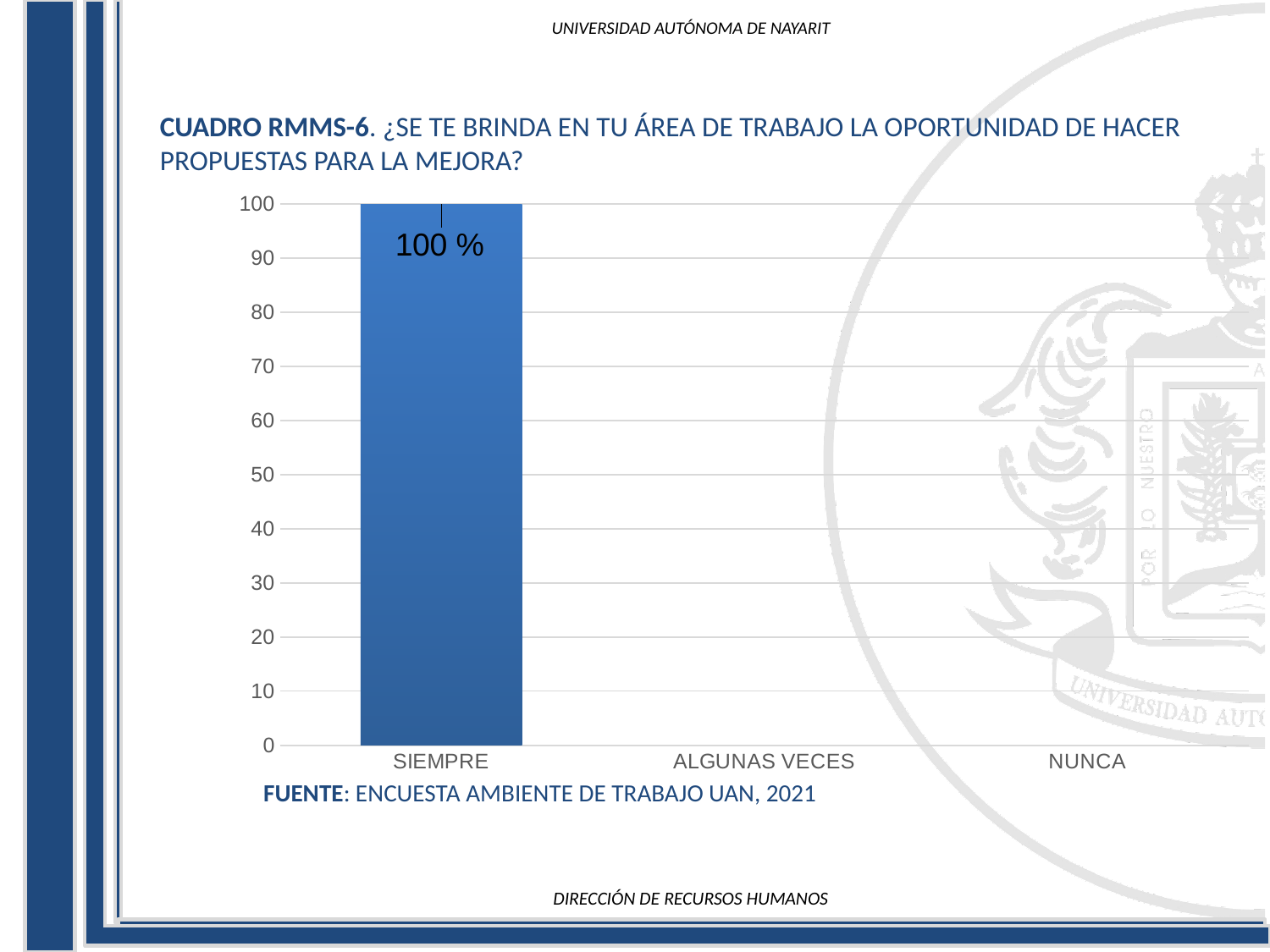
What is the title of the chart? CUADRO RMMS-6. ¿SE TE BRINDA EN TU ÁREA DE TRABAJO LA OPORTUNIDAD DE HACER PROPUESTAS PARA LA MEJORA? Which is larger, the value for SIEMPRE or the value for NUNCA? SIEMPRE Which category has the highest value? SIEMPRE How many categories are shown on the x axis? 3 What source is cited below the chart? ENCUESTA AMBIENTE DE TRABAJO UAN, 2021 Is the value for ALGUNAS VECES greater or less than 50? less What is the value for SIEMPRE? 100 % Is the value for SIEMPRE greater or less than 90? greater What kind of chart is shown on the slide? bar chart Which is larger, the value for SIEMPRE or the value for ALGUNAS VECES? SIEMPRE Is the value for NUNCA greater or less than 10? less